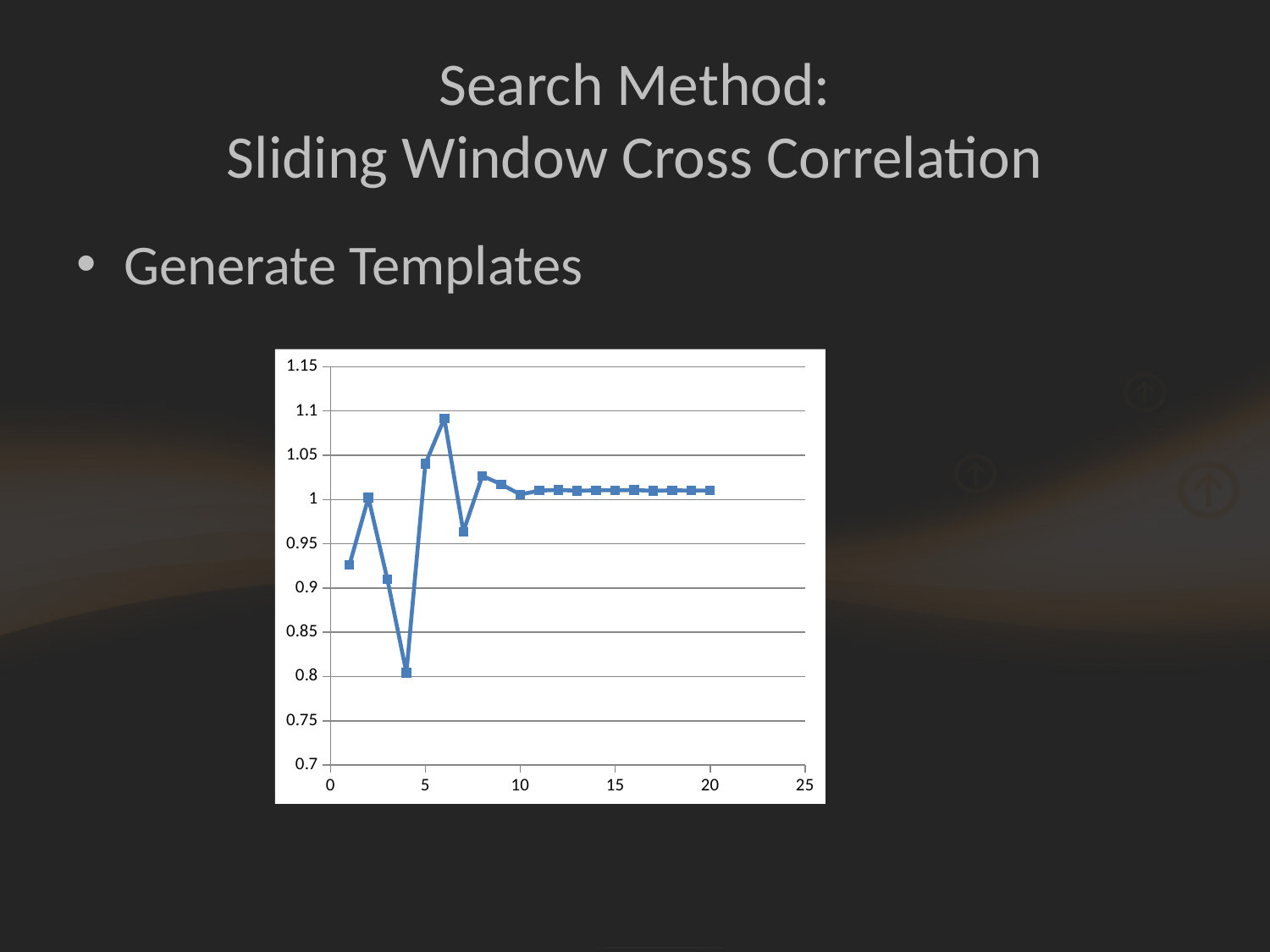
At which x value does the line reach its lowest point? 4 Is the value at x = 4 greater or less than 0.85? less What kind of chart is shown on the slide? line chart Is the value at x = 1 greater or less than 0.95? less Is the value at x = 6 greater or less than 1.05? greater At which x value does the line reach its highest point? 6 From x = 11 to x = 20, does the line rise, fall, or stay flat? stay flat How many data points are plotted on the line? 20 What is the highest tick label shown on the y axis? 1.15 Which has the larger value, the point at x = 4 or the point at x = 7? x = 7 Which has the larger value, the point at x = 5 or the point at x = 6? x = 6